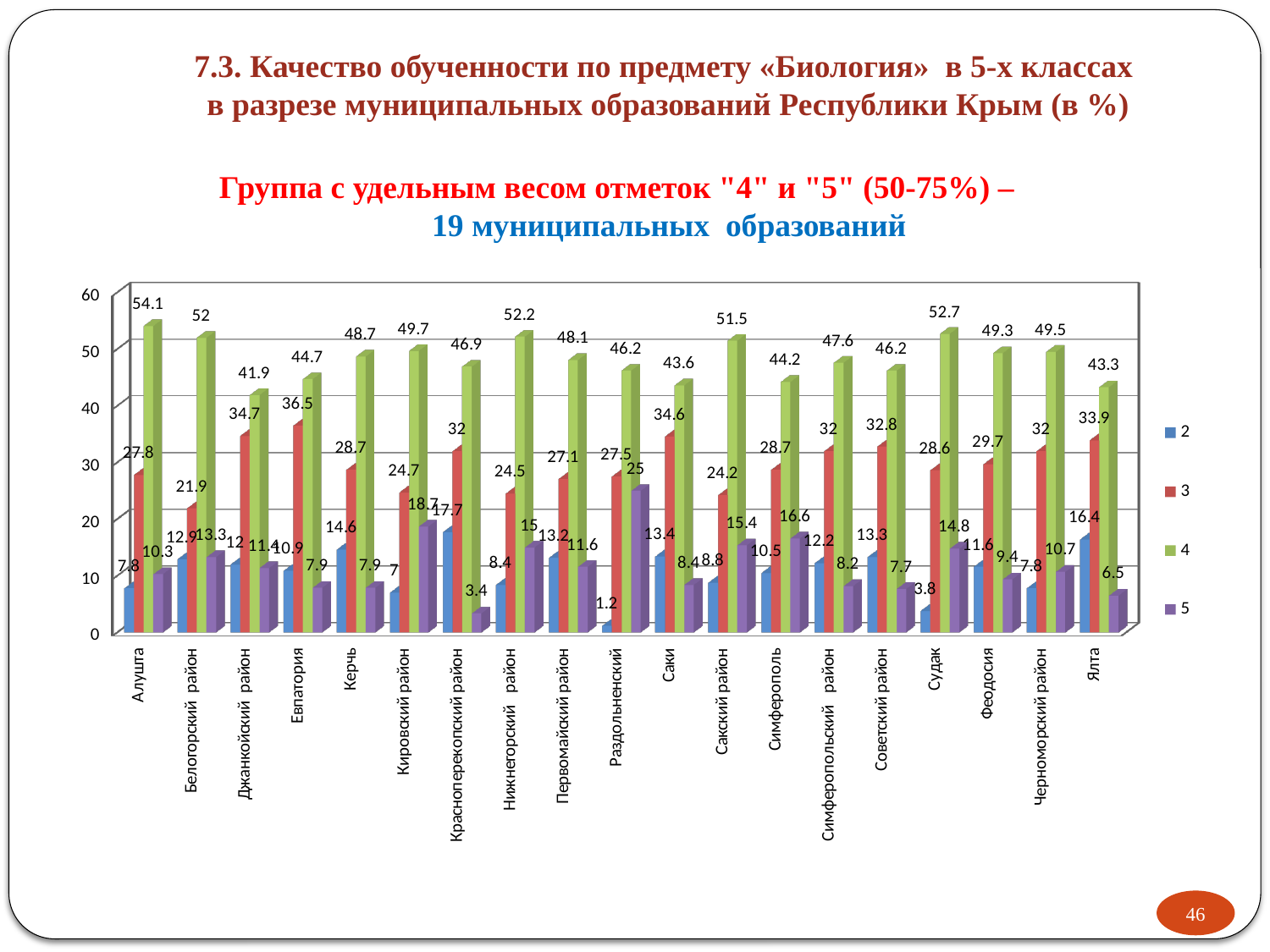
Which municipality has the highest value for series "4"? Алушта What is the value of series "5" for Раздольненский? 25 Which municipality has the lowest value for series "5"? Красноперекопский район What type of chart is shown on the slide? Bar chart What is the value of series "4" for Алушта? 54.1 How many municipalities are shown on the x axis of the chart? 19 What is the value of series "3" for Евпатория? 36.5 Which municipality has the lowest value for series "2"? Раздольненский What is the value of series "2" for Судак? 3.8 What is the difference between the series "4" value for Судак and the series "4" value for Ялта? 9.4 How many series does the legend list? 4 Which is larger: the series "3" value for Саки or the series "3" value for Сакский район? Саки